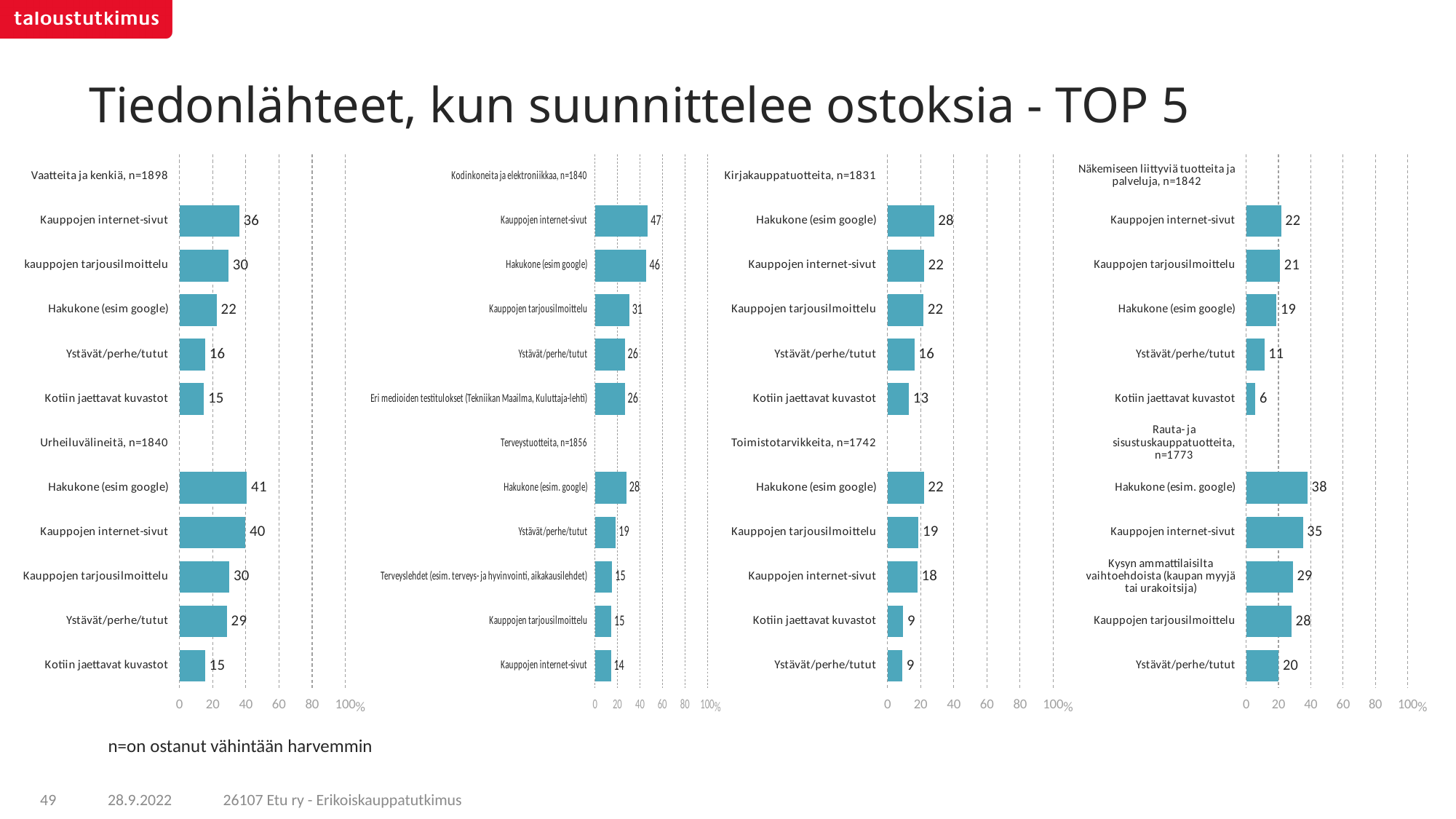
In the rightmost chart, what is the value for Kysyn ammattilaisilta vaihtoehdoista (kaupan myyjä tai urakoitsija) under Rauta- ja sisustuskauppatuotteita, n=1773? 29 In the second chart from the left, how many sources are listed under Terveystuotteita, n=1856? 5 In the leftmost chart, which source has the highest value under Urheiluvälineitä, n=1840? Hakukone (esim google) In the third chart from the left, what is the value for Kotiin jaettavat kuvastot under Kirjakauppatuotteita, n=1831? 13 What is the title of the slide? Tiedonlähteet, kun suunnittelee ostoksia - TOP 5 In the leftmost chart, what is the value for Kauppojen internet-sivut under Vaatteita ja kenkiä, n=1898? 36 In the rightmost chart, which source has the lowest value under Näkemiseen liittyviä tuotteita ja palveluja, n=1842? Kotiin jaettavat kuvastot What type of chart is used on this slide? Bar chart In the second chart from the left, what is the difference between Kauppojen internet-sivut (47) and Kauppojen tarjousilmoittelu (31) under Kodinkoneita ja elektroniikkaa, n=1840? 16 In the rightmost chart, is the value for Hakukone (esim. google) under Rauta- ja sisustuskauppatuotteita, n=1773 greater or less than 20? greater In the second chart from the left, what is the value for Hakukone (esim google) under Kodinkoneita ja elektroniikkaa, n=1840? 46 In the third chart from the left, which is larger under Toimistotarvikkeita, n=1742: Hakukone (esim google) or Kauppojen internet-sivut? Hakukone (esim google)